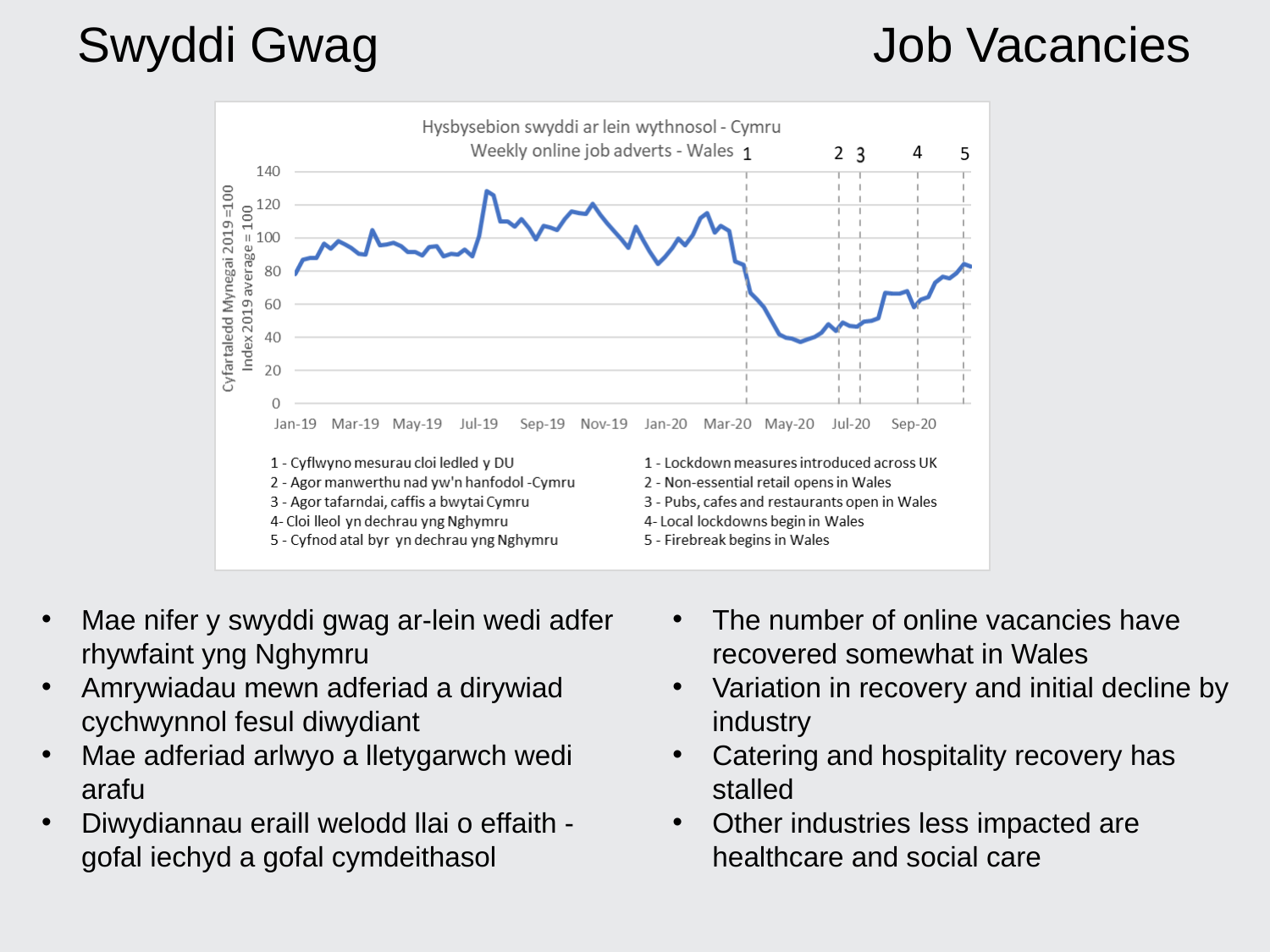
Is the value around Jul-19 higher or lower than the value around May-20? higher Is the highest value of the line, around Jul-19, greater or less than 120? greater Around which month does the line reach its lowest value? May-20 Is the value at the start of the line, at Jan-19, greater or less than 100? less According to the chart's key, what does the dashed line labelled 1 mark? Lockdown measures introduced across UK Do the values rise or fall between May-20 and the end of the line? rise What kind of chart is shown on the slide? line chart Do the values rise or fall between Mar-20 and May-20? fall Around which month does the line reach its highest value? Jul-19 Is the value at Jan-20 greater or less than 60? greater What is the English title of the chart? Weekly online job adverts - Wales